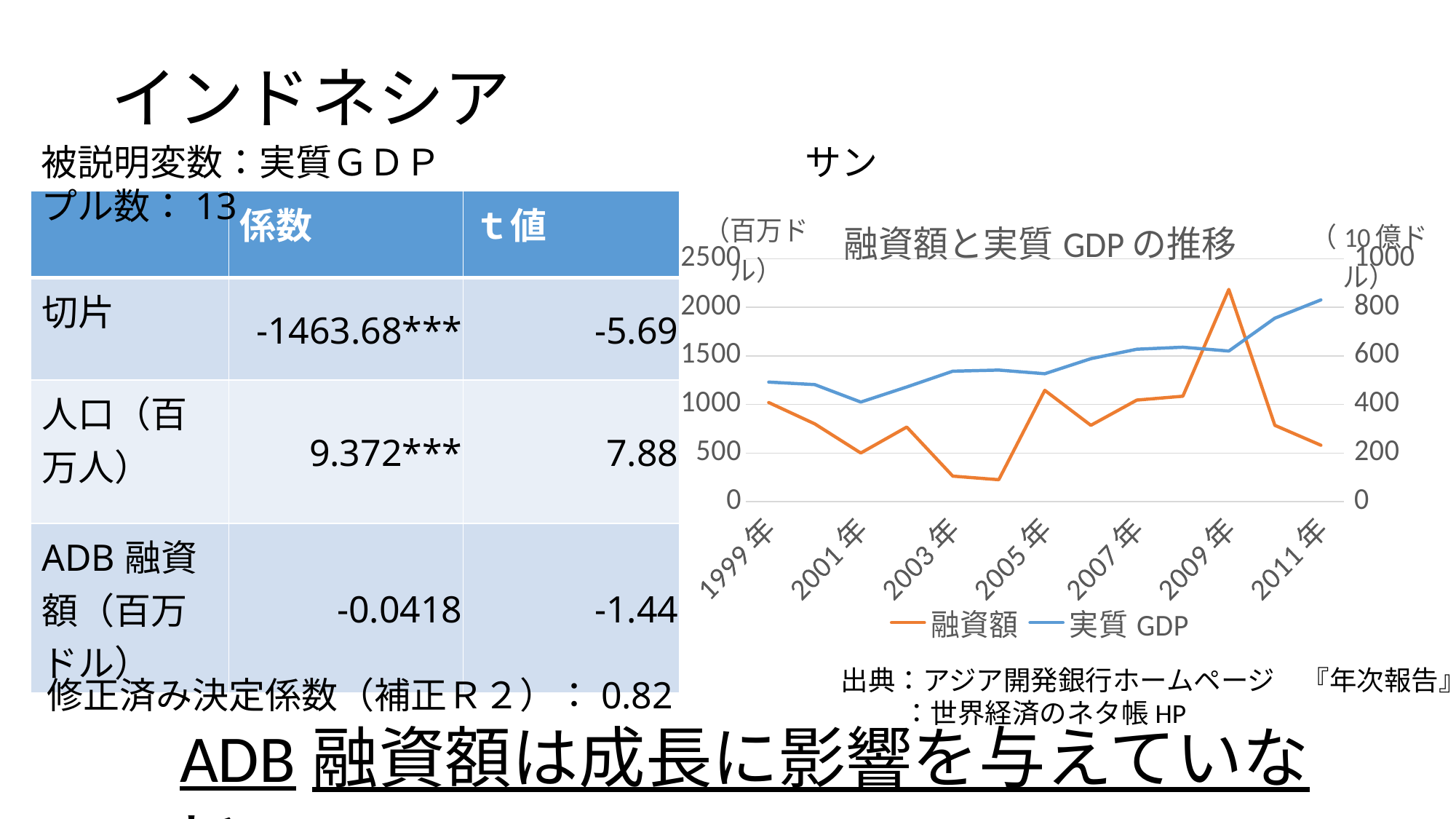
Which is larger for 融資額: the value in 2009年 or the value in 2011年? 2009年 How many series does the chart legend list? 2 In which year does 融資額 reach its highest value? 2009年 What kind of chart is shown on the slide? line chart Is the value of 実質GDP in 2011年 greater or less than 600 on the right axis? greater What is the title of the chart? 融資額と実質GDPの推移 Which series is drawn in orange in the chart? 融資額 What is the first year shown on the x axis of the chart? 1999年 Is the value of 融資額 in 2009年 greater or less than 2000 on the left axis? greater Does 実質GDP generally rise or fall from 1999年 to 2011年? rise Is the value of 実質GDP in 2001年 greater or less than 500 on the right axis? less